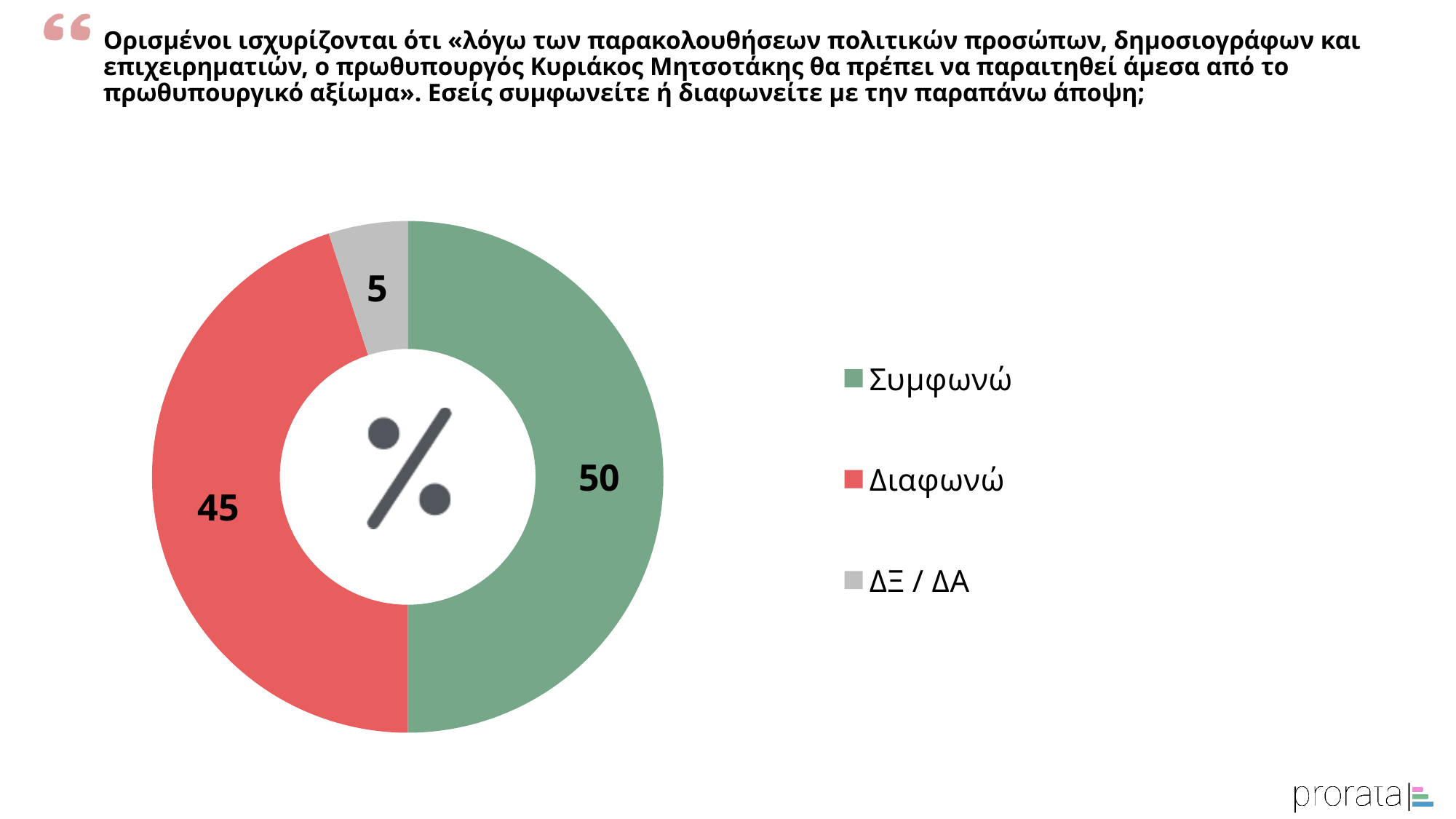
Which is larger, the value for Συμφωνώ or the value for Διαφωνώ? Συμφωνώ How many entries does the legend list? 3 What kind of chart is shown on the slide? Pie chart (doughnut) What is the value for Συμφωνώ? 50 Which category has the lowest value? ΔΞ / ΔΑ How many categories does the chart show? 3 What is the difference between the values for Διαφωνώ and ΔΞ / ΔΑ? 40 What is the difference between the values for Συμφωνώ and Διαφωνώ? 5 Which category has the highest value? Συμφωνώ What is the value for Διαφωνώ? 45 What colour is the Διαφωνώ slice? Red What is the value for ΔΞ / ΔΑ? 5